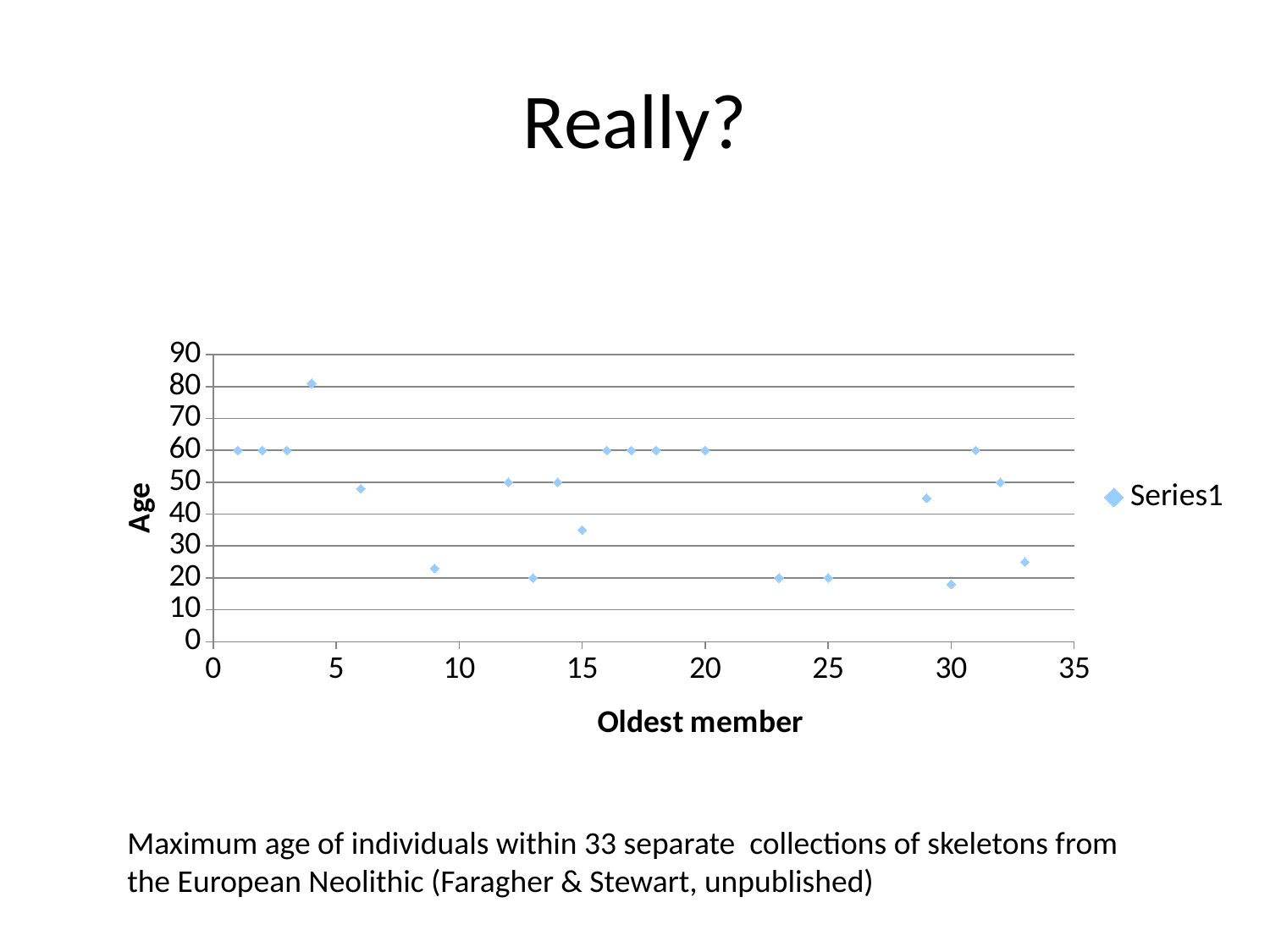
Which has the larger Age value: the point at Oldest member 6 or the point at Oldest member 9? Oldest member 6 What kind of chart is shown on the slide? scatter chart What is the legend entry for the plotted series? Series1 Is the Age value for the point at Oldest member 15 greater or less than 30? greater What is the Age value for the point at Oldest member 1? 60 What is the Age value for the point at Oldest member 13? 20 What is the Age value for the point at Oldest member 32? 50 Is the Age value for the point at Oldest member 30 greater or less than 20? less Is the Age value for the point at Oldest member 4 greater or less than 70? greater How many series does the legend list? 1 What is the title of the vertical axis? Age At which Oldest member value is the highest Age plotted? 4